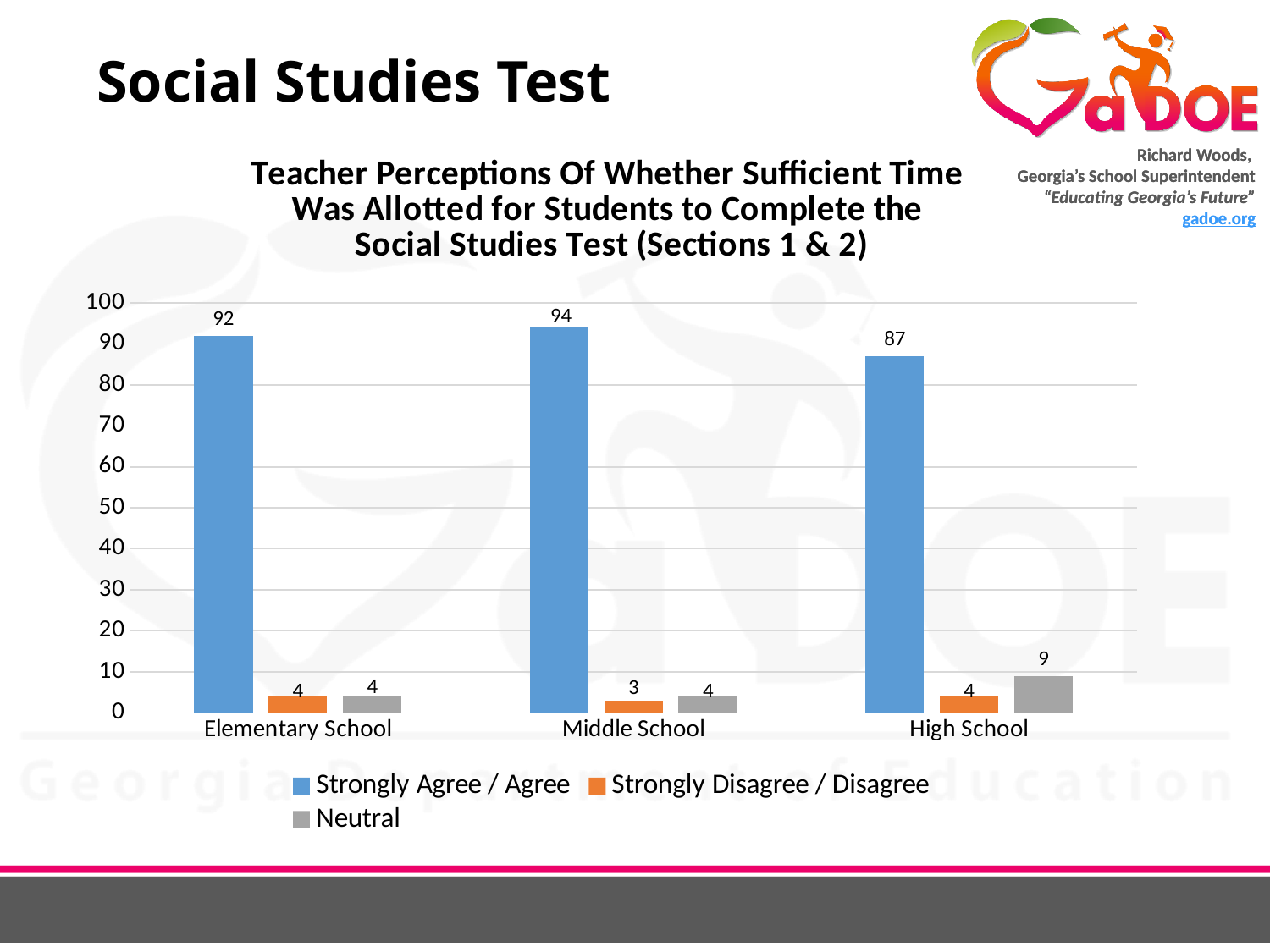
What is the difference between the Strongly Agree / Agree values for Middle School and High School? 7 Which school level has the highest Strongly Agree / Agree value? Middle School What is the Neutral value for High School? 9 Which is larger: the Neutral value for High School or the Neutral value for Elementary School? High School Which colour represents the Neutral series? Gray How many school levels are shown on the x axis? 3 Which school level has the lowest Strongly Agree / Agree value? High School How many series does the legend list? 3 What kind of chart is shown on the slide? Bar chart What is the Strongly Disagree / Disagree value for Middle School? 3 Is the Strongly Agree / Agree value for High School greater or less than 80? greater What is the Strongly Agree / Agree value for Elementary School? 92